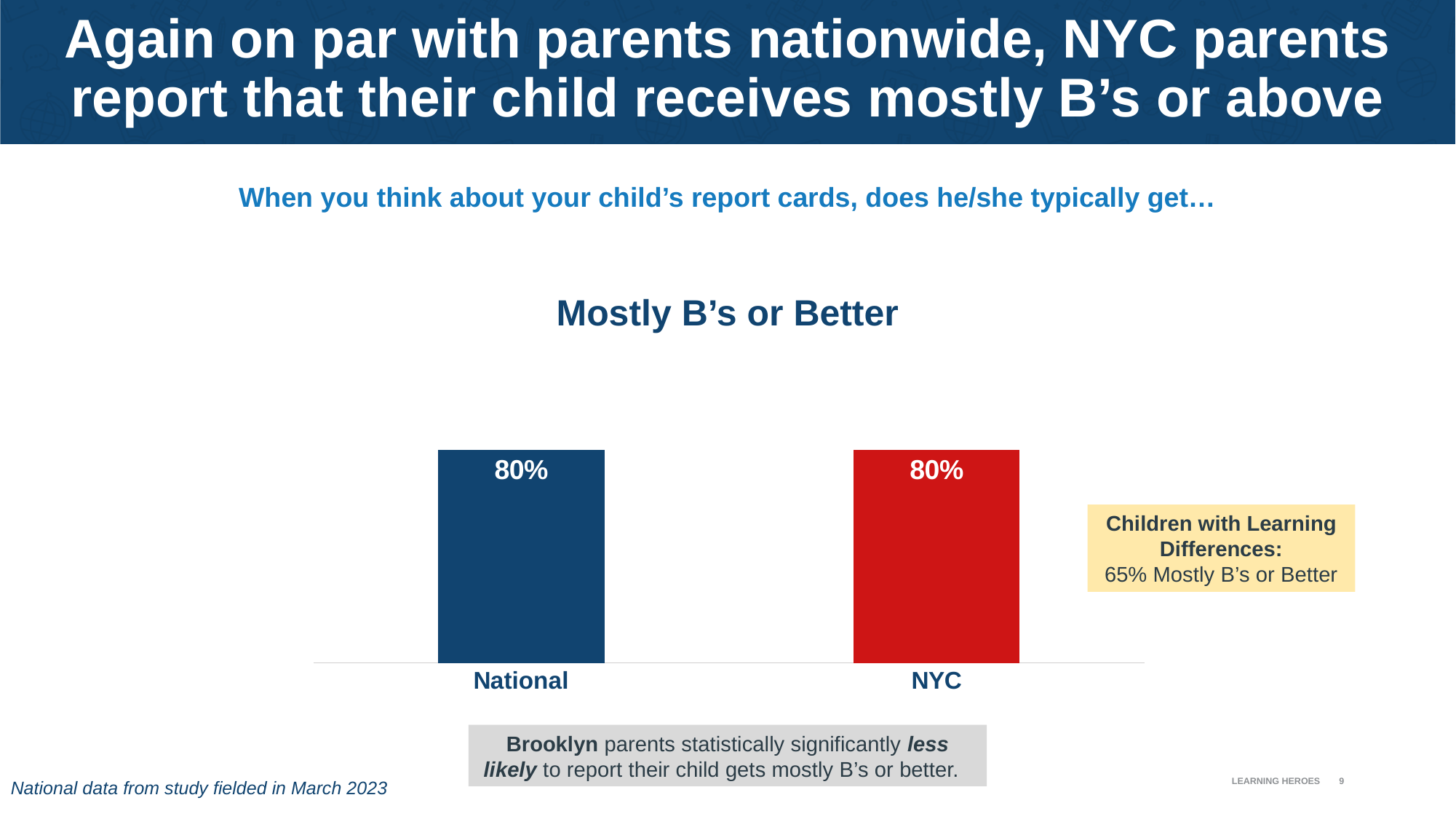
What is the value for National in the Mostly B's or Better chart? 80% What percentage of children with learning differences get mostly B's or better, according to the callout box? 65% What is the difference between the National and NYC values? 0% How many categories are shown in the chart? 2 What colour is the NYC bar? red Which category is labelled on the left bar of the chart? National What is the title of the chart? Mostly B's or Better Is the NYC value larger than, smaller than, or equal to the National value? equal What kind of chart is shown on the slide? bar chart What is the value for NYC in the Mostly B's or Better chart? 80%